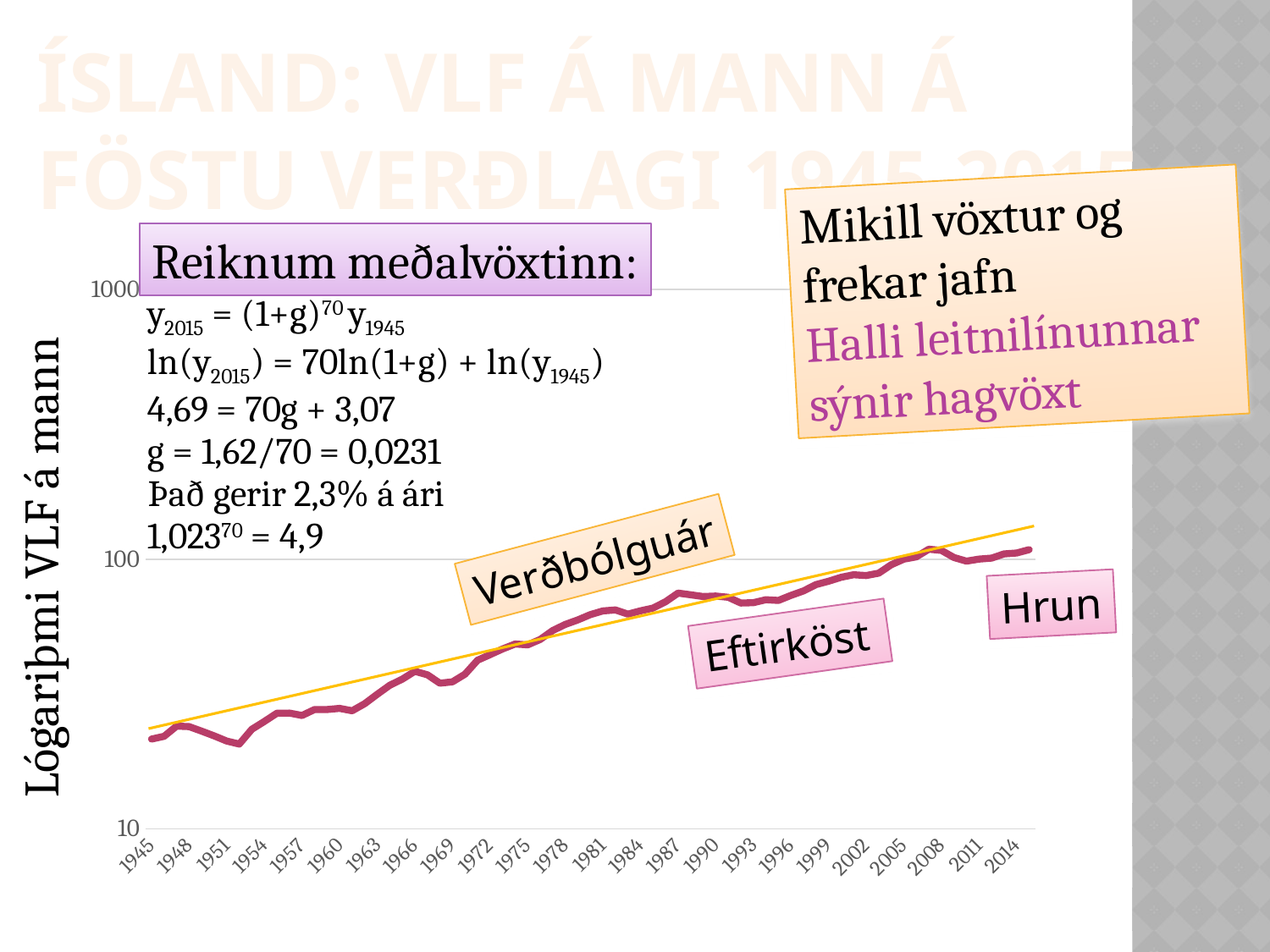
Is the value for 1990 greater or less than 100? less How many tick values are labelled on the y axis? 3 Is the value for 1945 greater or less than 100? less Which is larger, the value for 1951 or the value for 1966? 1966 What is the label on the y axis of the chart? Lógariþmi VLF á mann What kind of chart is shown on the slide? line chart Is the value for 1960 greater or less than 10? greater Do the plotted values generally rise or fall from 1945 to 2014? rise How many year labels are shown on the x axis? 24 What label is placed near the end of the line, around 2008-2014? Hrun Which is larger, the value for 1945 or the value for 1990? 1990